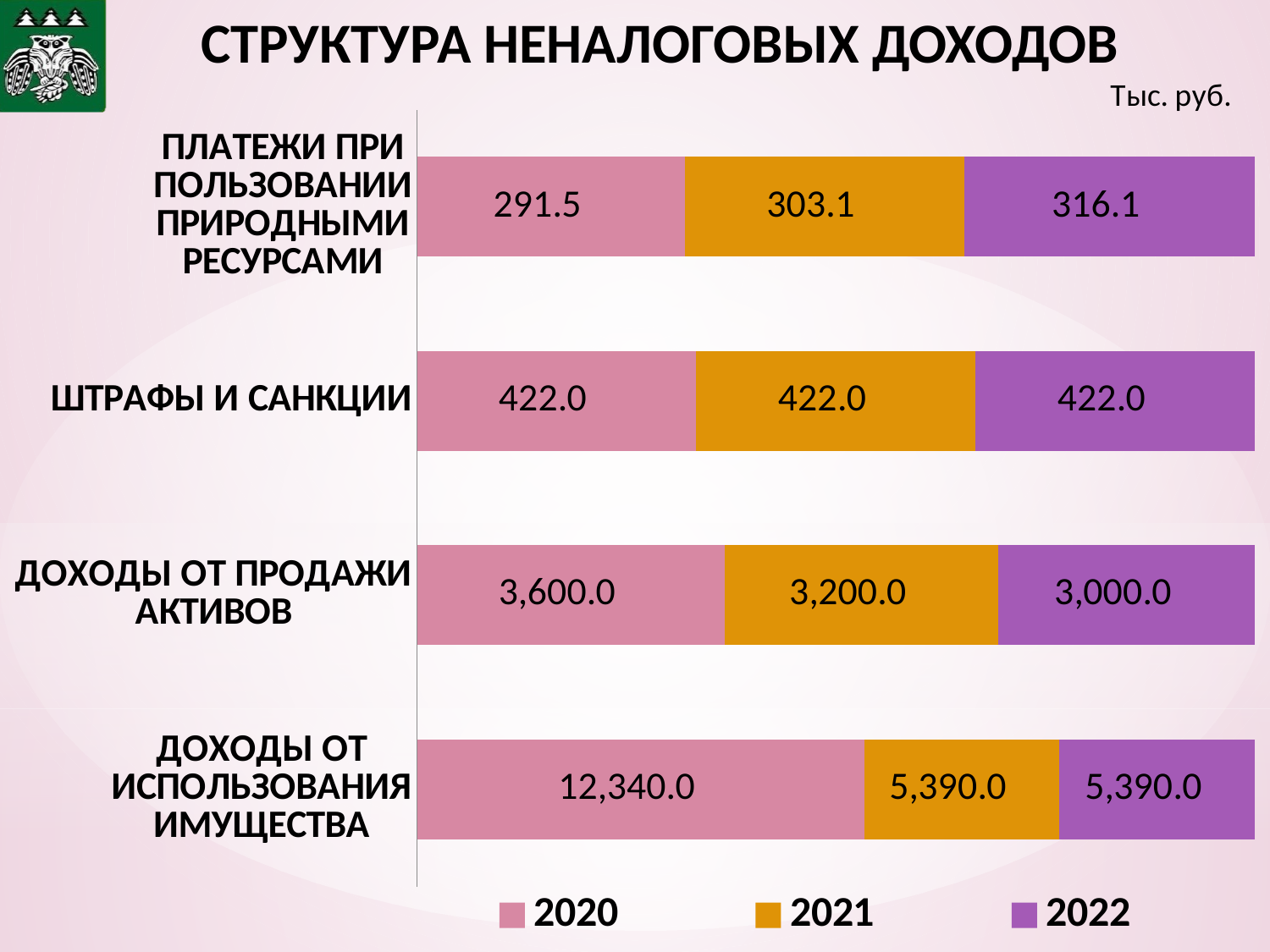
How many series does the legend list? 3 What kind of chart is shown on the slide? Stacked bar chart Which category has the highest 2020 value? ДОХОДЫ ОТ ИСПОЛЬЗОВАНИЯ ИМУЩЕСТВА What is the 2021 value for ДОХОДЫ ОТ ПРОДАЖИ АКТИВОВ? 3,200.0 Do the values for ДОХОДЫ ОТ ПРОДАЖИ АКТИВОВ rise or fall from 2020 to 2022? Fall What is the difference between the 2020 and 2021 values for ДОХОДЫ ОТ ИСПОЛЬЗОВАНИЯ ИМУЩЕСТВА? 6,950.0 Which category has the lowest 2022 value? ПЛАТЕЖИ ПРИ ПОЛЬЗОВАНИИ ПРИРОДНЫМИ РЕСУРСАМИ Which is larger for ДОХОДЫ ОТ ПРОДАЖИ АКТИВОВ: the 2020 value or the 2022 value? 2020 How many categories are shown in the chart? 4 What is the 2020 value for ДОХОДЫ ОТ ИСПОЛЬЗОВАНИЯ ИМУЩЕСТВА? 12,340.0 What is the 2021 value for ШТРАФЫ И САНКЦИИ? 422.0 What is the 2022 value for ПЛАТЕЖИ ПРИ ПОЛЬЗОВАНИИ ПРИРОДНЫМИ РЕСУРСАМИ? 316.1